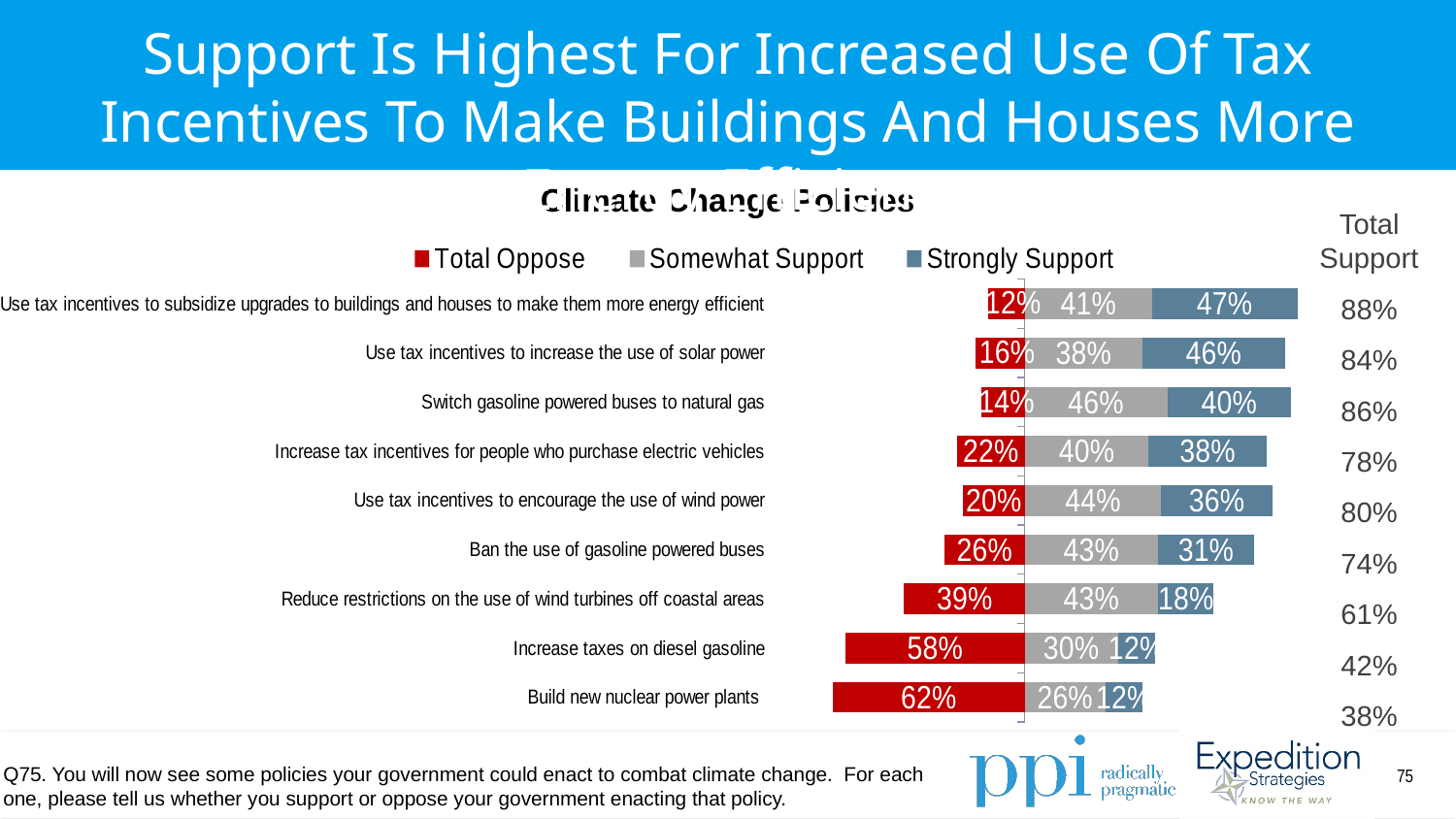
Which policy has the highest Total Oppose value? Build new nuclear power plants How many series does the legend list? 3 What is the Strongly Support value for 'Use tax incentives to increase the use of solar power'? 46% Which is larger: the Strongly Support value for 'Increase tax incentives for people who purchase electric vehicles' or for 'Use tax incentives to encourage the use of wind power'? Increase tax incentives for people who purchase electric vehicles What is the Total Oppose value for 'Build new nuclear power plants'? 62% What is the Somewhat Support value for 'Switch gasoline powered buses to natural gas'? 46% What is the combined Somewhat Support and Strongly Support total for 'Use tax incentives to subsidize upgrades to buildings and houses to make them more energy efficient'? 88% What is the difference between the Total Oppose values for 'Reduce restrictions on the use of wind turbines off coastal areas' and 'Ban the use of gasoline powered buses'? 13% What kind of chart is shown on the slide? Stacked bar chart What colour represents the Total Oppose series in the chart? Red Which policy has the lowest Strongly Support value? Increase taxes on diesel gasoline and Build new nuclear power plants (both 12%) How many policies are plotted in the chart? 9